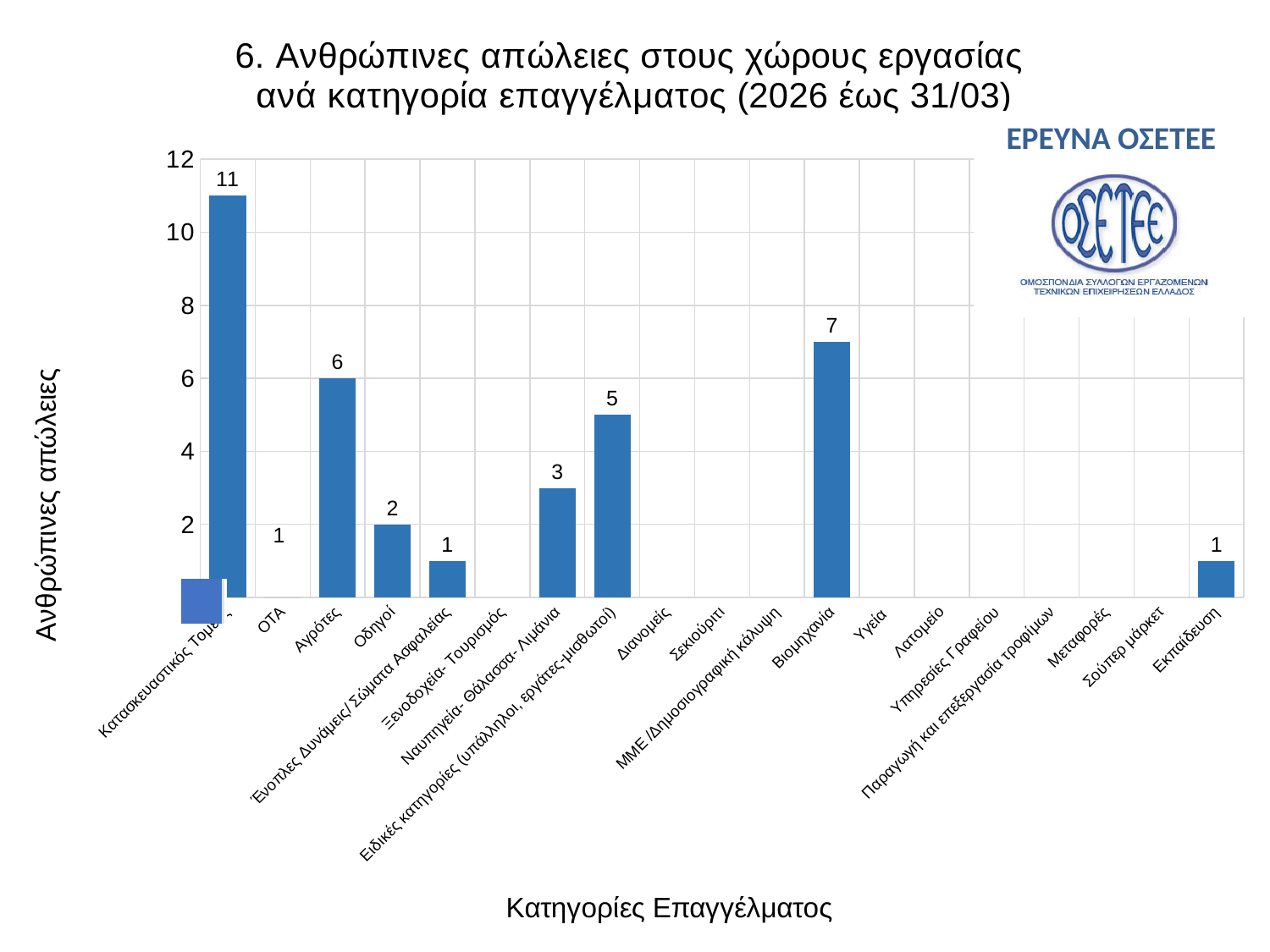
What is the difference between the values for Κατασκευαστικός Τομέας and Βιομηχανία? 4 What is the value for Ειδικές κατηγορίες (υπάλληλοι, εργάτες-μισθωτοί)? 5 How many categories are shown on the x axis? 19 What is the label of the y axis? Ανθρώπινες απώλειες What is the value for Αγρότες? 6 Which category has the highest value? Κατασκευαστικός Τομέας What is the value for Ναυπηγεία- Θάλασσα- Λιμάνια? 3 What type of chart is shown on the slide? Bar chart What is the value for Βιομηχανία? 7 Which is larger, the value for Αγρότες or the value for Οδηγοί? Αγρότες What is the value for Κατασκευαστικός Τομέας? 11 What is the value for Εκπαίδευση? 1